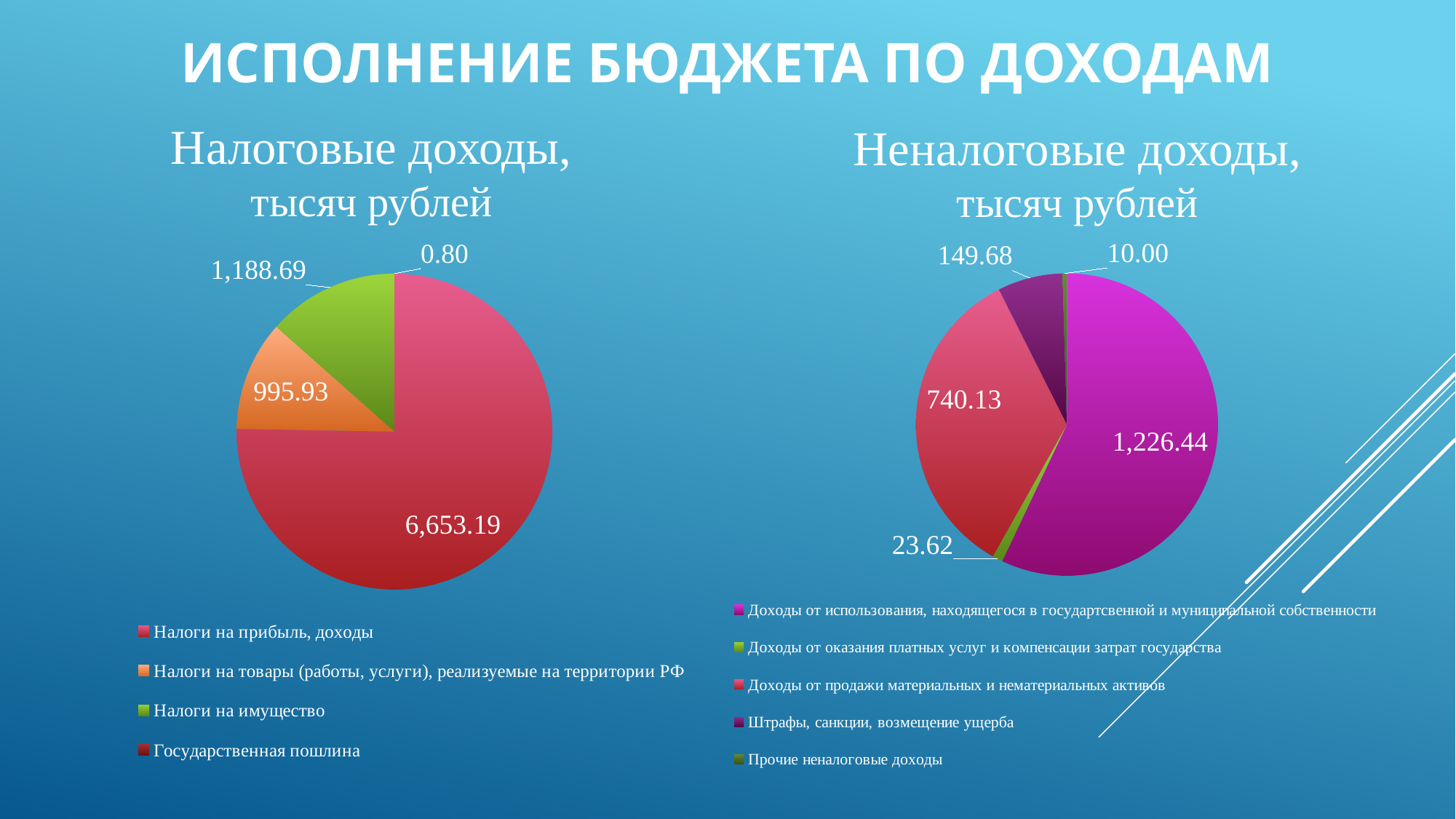
In the 'Неналоговые доходы, тысяч рублей' chart, what is the value for 'Доходы от продажи материальных и нематериальных активов'? 740.13 What type of chart is the 'Налоговые доходы, тысяч рублей' chart? Pie chart In the 'Налоговые доходы, тысяч рублей' chart, what is the difference between 'Налоги на имущество' and 'Налоги на товары (работы, услуги), реализуемые на территории РФ'? 192.76 What is the total of all values in the 'Неналоговые доходы, тысяч рублей' chart? 2,149.87 In the 'Налоговые доходы, тысяч рублей' chart, which category has the largest value? Налоги на прибыль, доходы In the 'Налоговые доходы, тысяч рублей' chart, what is the value for 'Налоги на имущество'? 1,188.69 In the 'Неналоговые доходы, тысяч рублей' chart, what is the value for 'Штрафы, санкции, возмещение ущерба'? 149.68 In the 'Неналоговые доходы, тысяч рублей' chart, which is larger: 'Доходы от использования, находящегося в государственной и муниципальной собственности' or 'Доходы от продажи материальных и нематериальных активов'? Доходы от использования, находящегося в государственной и муниципальной собственности How many categories does the 'Налоговые доходы, тысяч рублей' chart show? 4 In the 'Налоговые доходы, тысяч рублей' chart, what is the value for 'Государственная пошлина'? 0.80 How many categories does the 'Неналоговые доходы, тысяч рублей' chart show? 5 In the 'Неналоговые доходы, тысяч рублей' chart, which category has the smallest value? Прочие неналоговые доходы